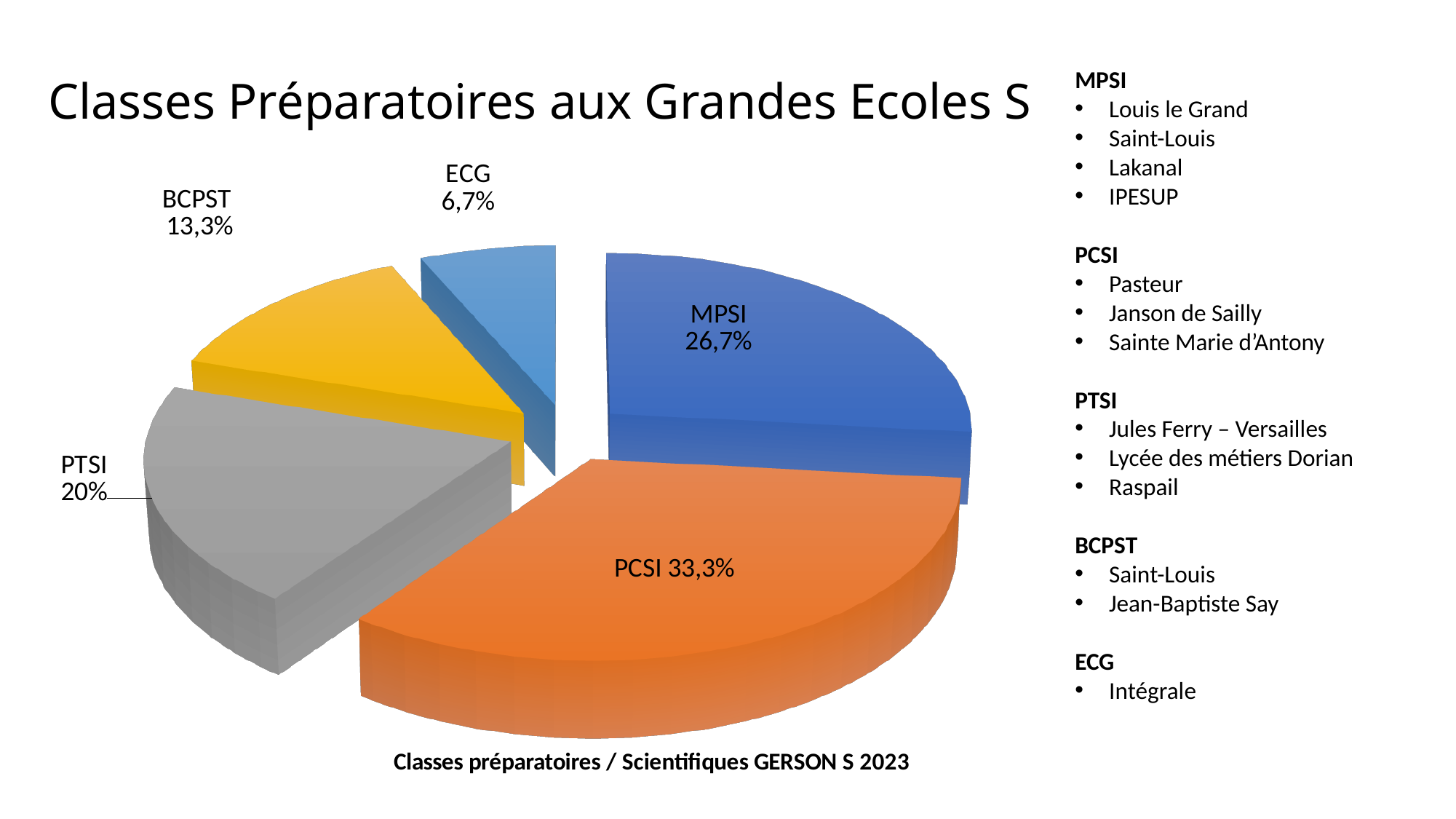
Which is larger, the share for MPSI or the share for PTSI? MPSI What share of the pie does PCSI represent? 33,3% What share of the pie does MPSI represent? 26,7% What share of the pie does BCPST represent? 13,3% What share of the pie does ECG represent? 6,7% Which category has the smallest slice of the pie? ECG What is the difference in percentage points between the PCSI share and the BCPST share? 20 percentage points How many slices does the pie chart have? 5 What is the title printed below the pie chart? Classes préparatoires / Scientifiques GERSON S 2023 What kind of chart is shown on the slide? Pie chart Which category has the largest slice of the pie? PCSI What share of the pie does PTSI represent? 20%